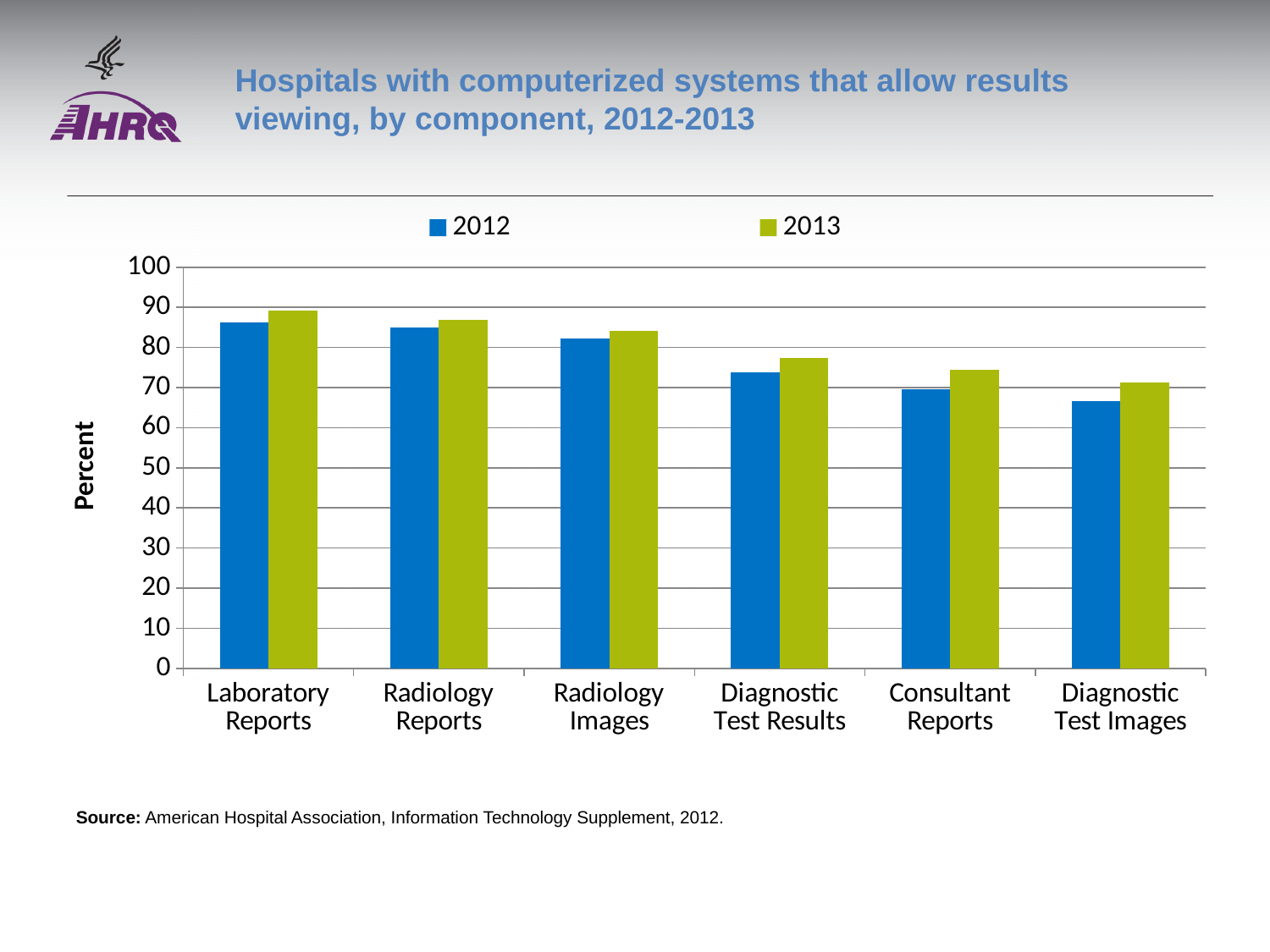
What kind of chart is shown on the slide? bar chart How many series does the legend list? 2 How many component categories are shown on the x axis? 6 Is the 2012 value for Diagnostic Test Images greater or less than 70? less Which component has the highest value for 2013? Laboratory Reports Which component has the lowest value for 2012? Diagnostic Test Images For Consultant Reports, which year has the larger value, 2012 or 2013? 2013 Is the 2013 value for Diagnostic Test Results greater or less than 80? less Is the 2012 value for Laboratory Reports greater or less than 80? greater Do the 2012 values rise or fall moving from left to right across the categories? fall What is the label on the vertical axis? Percent